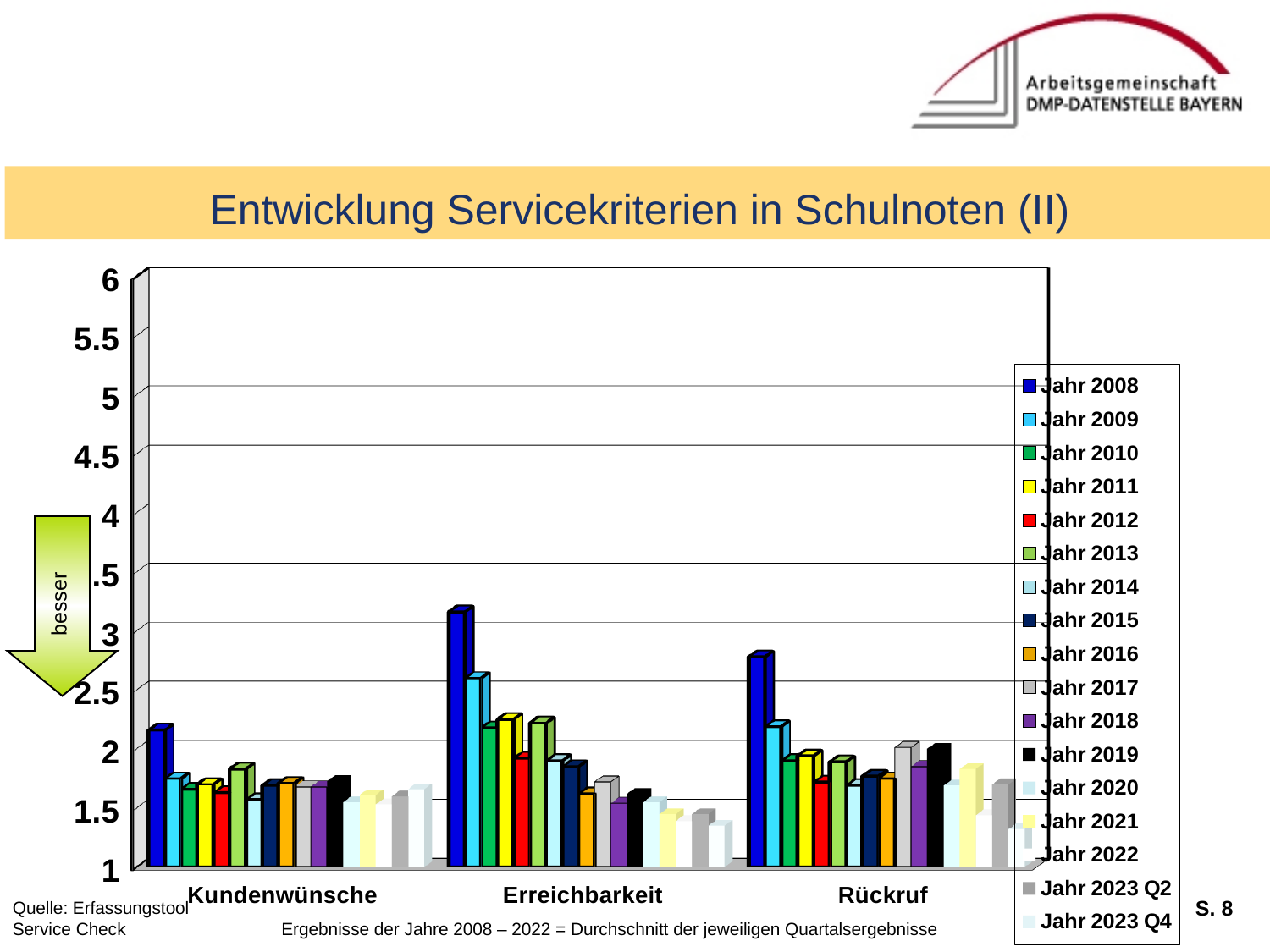
In the Erreichbarkeit category, is the Jahr 2008 bar higher or lower than the Jahr 2022 bar? higher What is the title of the chart on the slide? Entwicklung Servicekriterien in Schulnoten (II) Is the Jahr 2008 value for Kundenwünsche greater or less than 2? greater What kind of chart is shown on the slide? bar chart Is the Jahr 2009 value for Erreichbarkeit greater or less than 2.5? greater How many categories are shown on the x axis of the chart? 3 Which series has the highest bar in the Erreichbarkeit category? Jahr 2008 How many series does the chart's legend list? 17 Which category has the highest Jahr 2008 bar? Erreichbarkeit Is the Jahr 2008 value for Erreichbarkeit greater or less than 3? greater Which is larger: the Jahr 2008 value for Kundenwünsche or the Jahr 2008 value for Erreichbarkeit? Erreichbarkeit